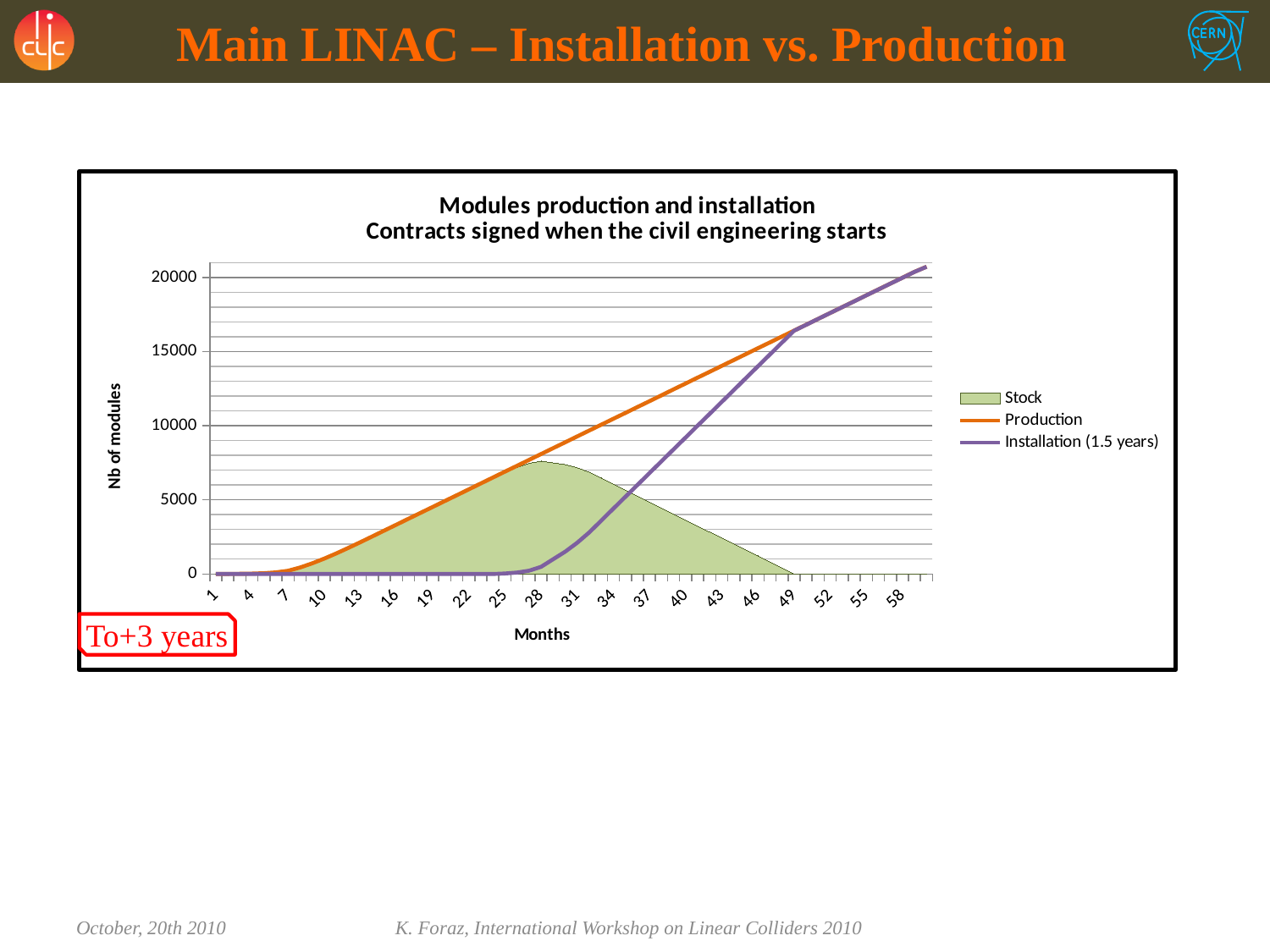
Does the Production series rise or fall as the months increase? rise Is the Installation (1.5 years) value at month 28 greater or less than 5000? less What is the title of the chart? Modules production and installation Contracts signed when the civil engineering starts At month 40, which is larger: Production or Installation (1.5 years)? Production Is the Production value at month 28 greater or less than 5000? greater Is the Installation (1.5 years) value at month 40 greater or less than 5000? greater At month 28, which is larger: Production or Installation (1.5 years)? Production How many series does the legend list? 3 What is the label of the y axis? Nb of modules What kind of chart is shown on the slide? combination area and line chart